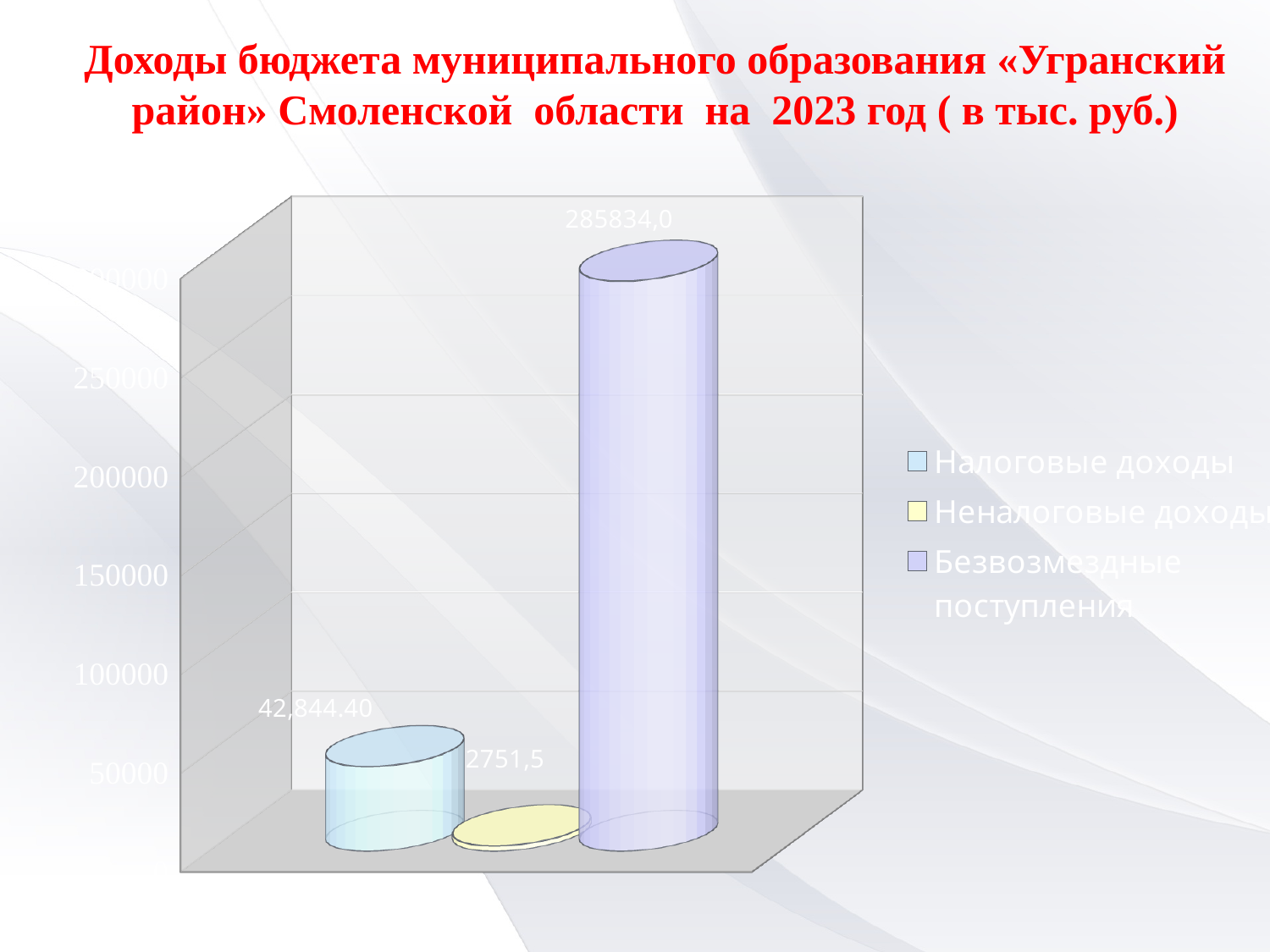
Is the value for Налоговые доходы greater or less than 50000? less Is the value for Безвозмездные поступления greater or less than 250000? greater Which series has the highest value? Безвозмездные поступления What is the difference between Налоговые доходы and Неналоговые доходы? 40092.9 How many series does the legend list? 3 What is the title of the chart? Доходы бюджета муниципального образования «Угранский район» Смоленской области на 2023 год ( в тыс. руб.) What is the value for Налоговые доходы? 42,844.40 What is the value for Неналоговые доходы? 2751,5 What is the value for Безвозмездные поступления? 285834,0 Which is larger, Налоговые доходы or Неналоговые доходы? Налоговые доходы What kind of chart is shown on the slide? Bar chart Which series has the lowest value? Неналоговые доходы